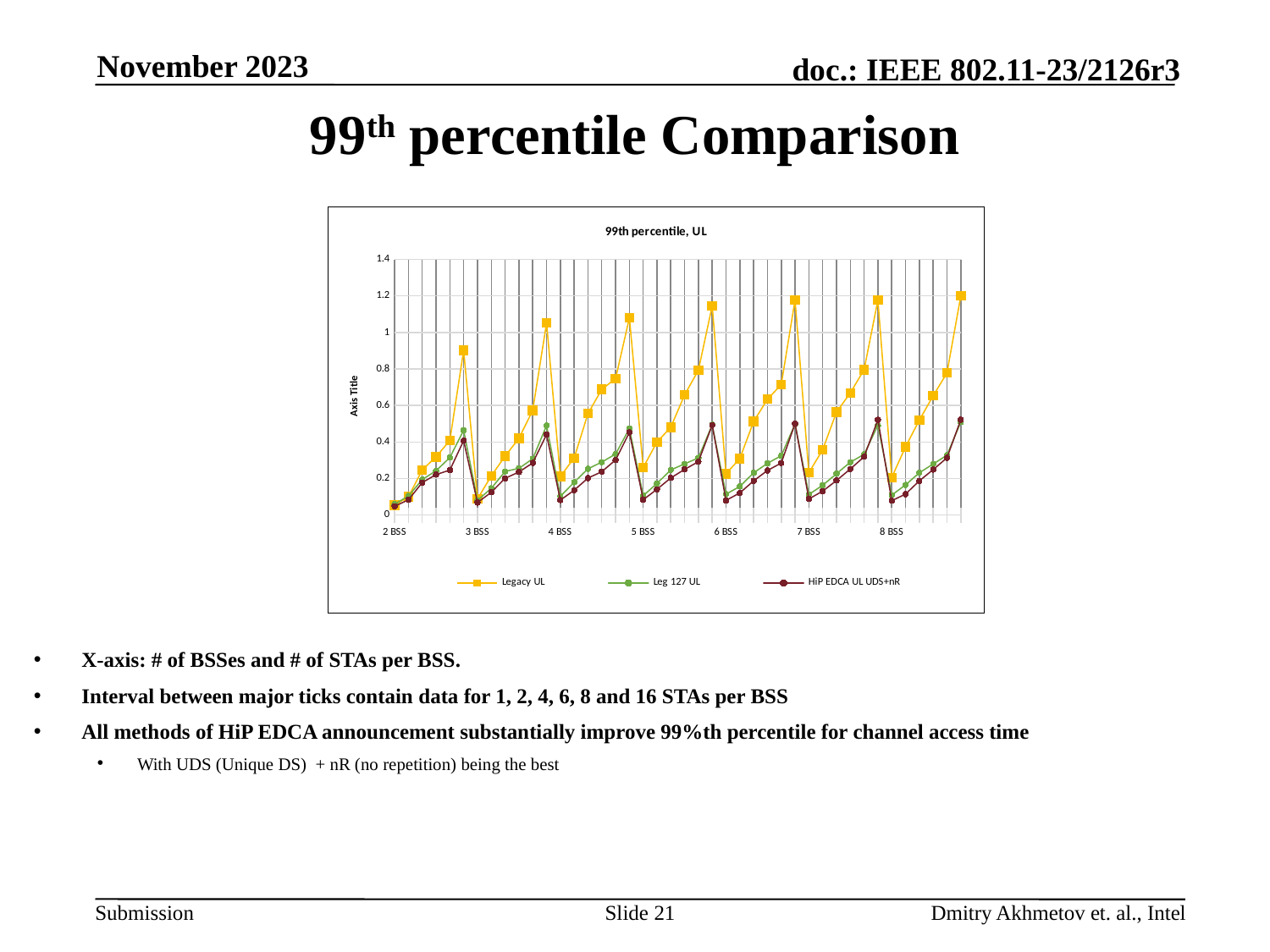
Is the highest Legacy UL value in the 2 BSS interval greater or less than 0.8? greater What is the title of the chart? 99th percentile, UL What kind of chart is shown on the slide? line chart How many BSS category labels are shown on the x axis of the chart? 7 Within each BSS interval, do the Legacy UL values rise or fall as the number of STAs per BSS increases? rise Is the highest Legacy UL value in the 8 BSS interval greater or less than 1? greater Is the highest HiP EDCA UL UDS+nR value in the 8 BSS interval greater or less than 0.6? less Which series reaches the highest value on the chart? Legacy UL At the peak of the 8 BSS interval, which series is larger: Legacy UL or HiP EDCA UL UDS+nR? Legacy UL Which series are listed in the chart legend? Legacy UL, Leg 127 UL, HiP EDCA UL UDS+nR How many series does the legend of the chart list? 3